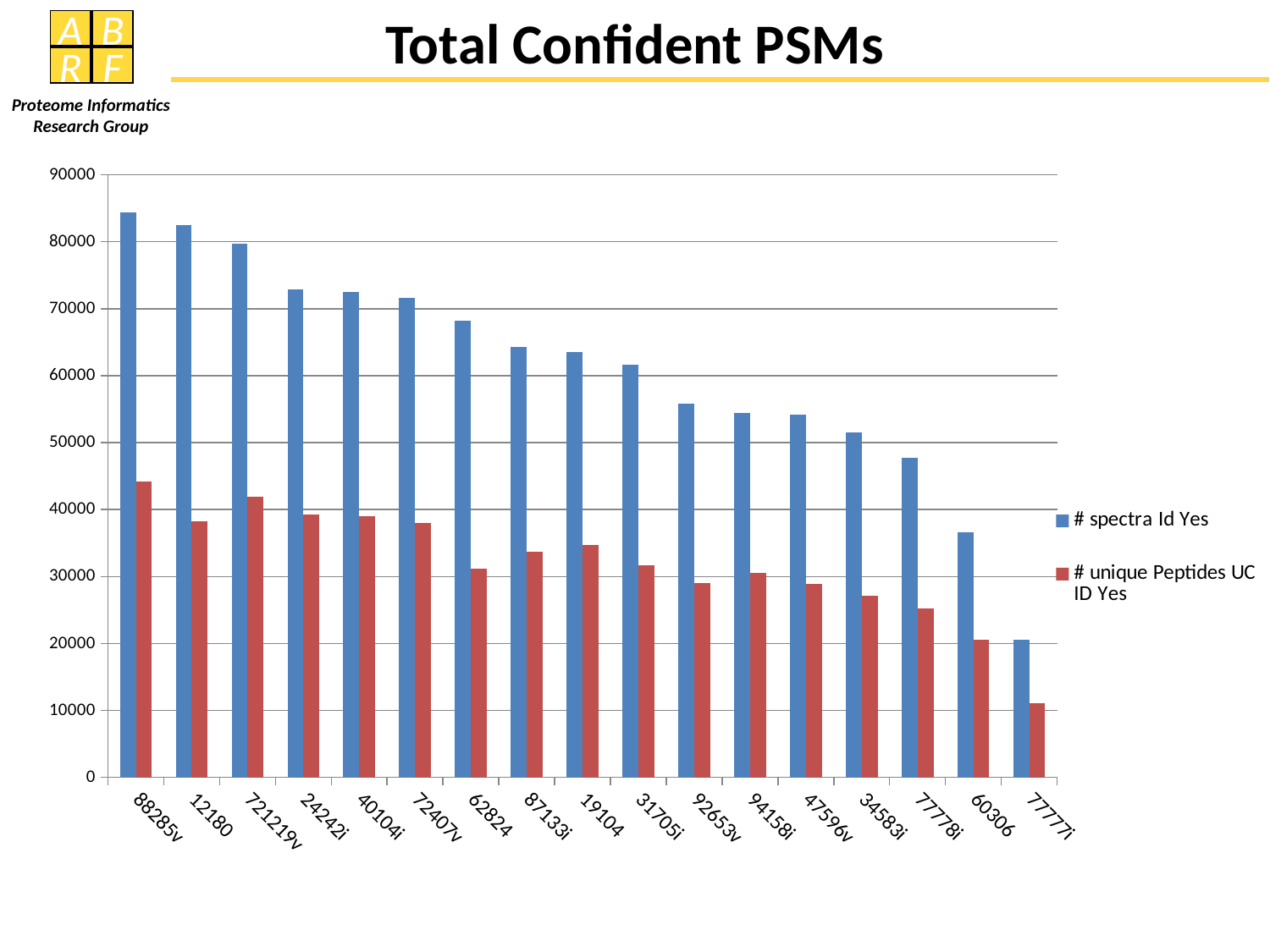
Is the # spectra Id Yes value for 88285v greater or less than 80000? greater Do the # spectra Id Yes values rise or fall from left to right along the x axis? fall Is the # unique Peptides UC ID Yes value for 77777i greater or less than 20000? less Which has the larger # unique Peptides UC ID Yes value, 721219v or 12180? 721219v Which category has the lowest value for # unique Peptides UC ID Yes? 77777i What kind of chart is shown on the slide? bar chart Which category has the lowest value for # spectra Id Yes? 77777i How many categories are shown on the x axis? 17 Is the # spectra Id Yes value for 77777i greater or less than 30000? less Which category has the highest value for # spectra Id Yes? 88285v How many series does the legend list? 2